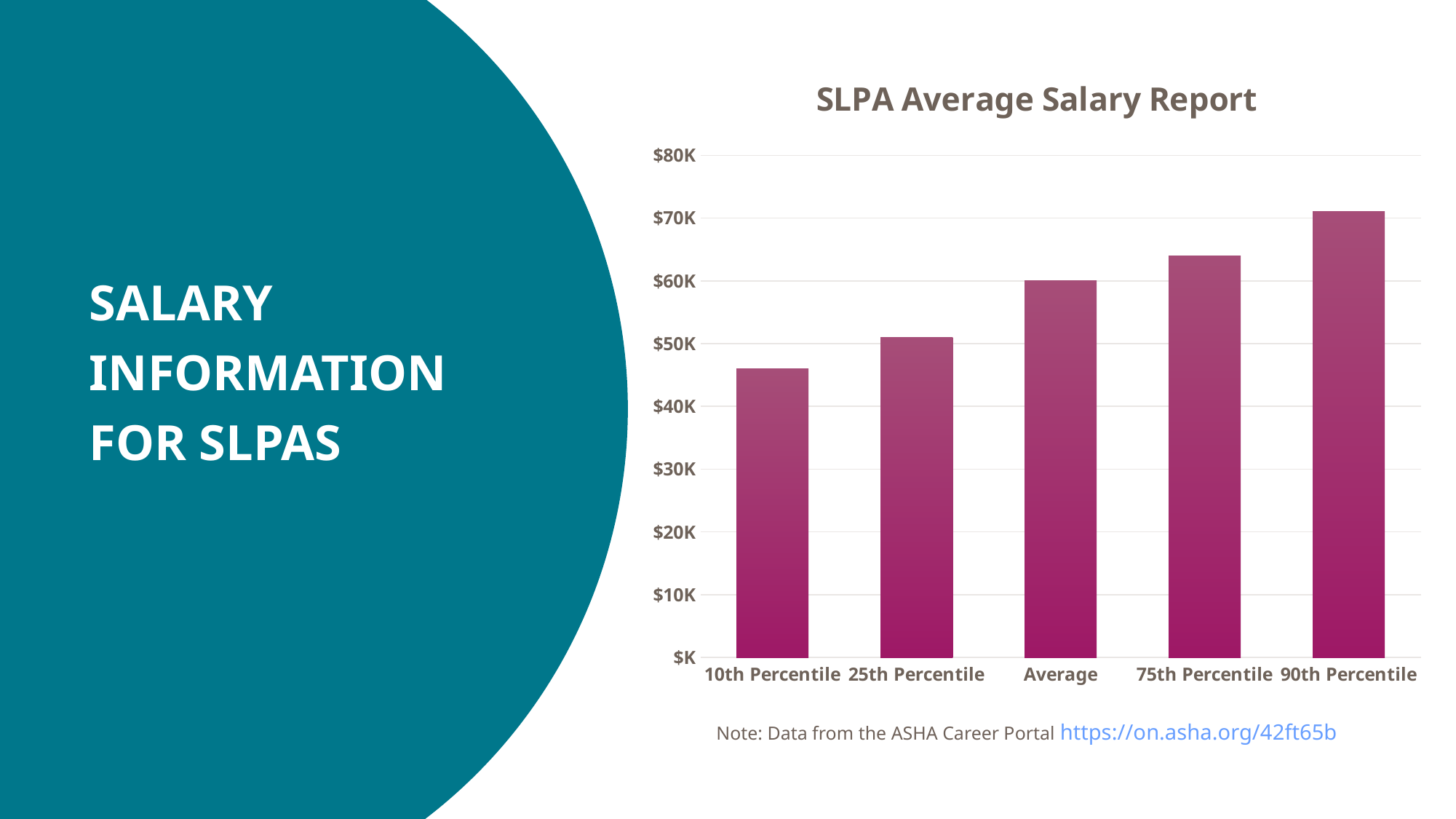
Which category has the highest value in the chart? 90th Percentile Is the value for 10th Percentile greater or less than $50K? less What type of chart is shown on the slide? bar chart How many categories are shown on the x axis of the chart? 5 Which is larger, the value for 75th Percentile or the value for Average? 75th Percentile What is the highest value labelled on the vertical axis of the chart? $80K Do the values rise or fall from left to right along the x axis? rise What is the title of the chart? SLPA Average Salary Report Which category has the lowest value in the chart? 10th Percentile Is the value for 75th Percentile greater or less than $70K? less